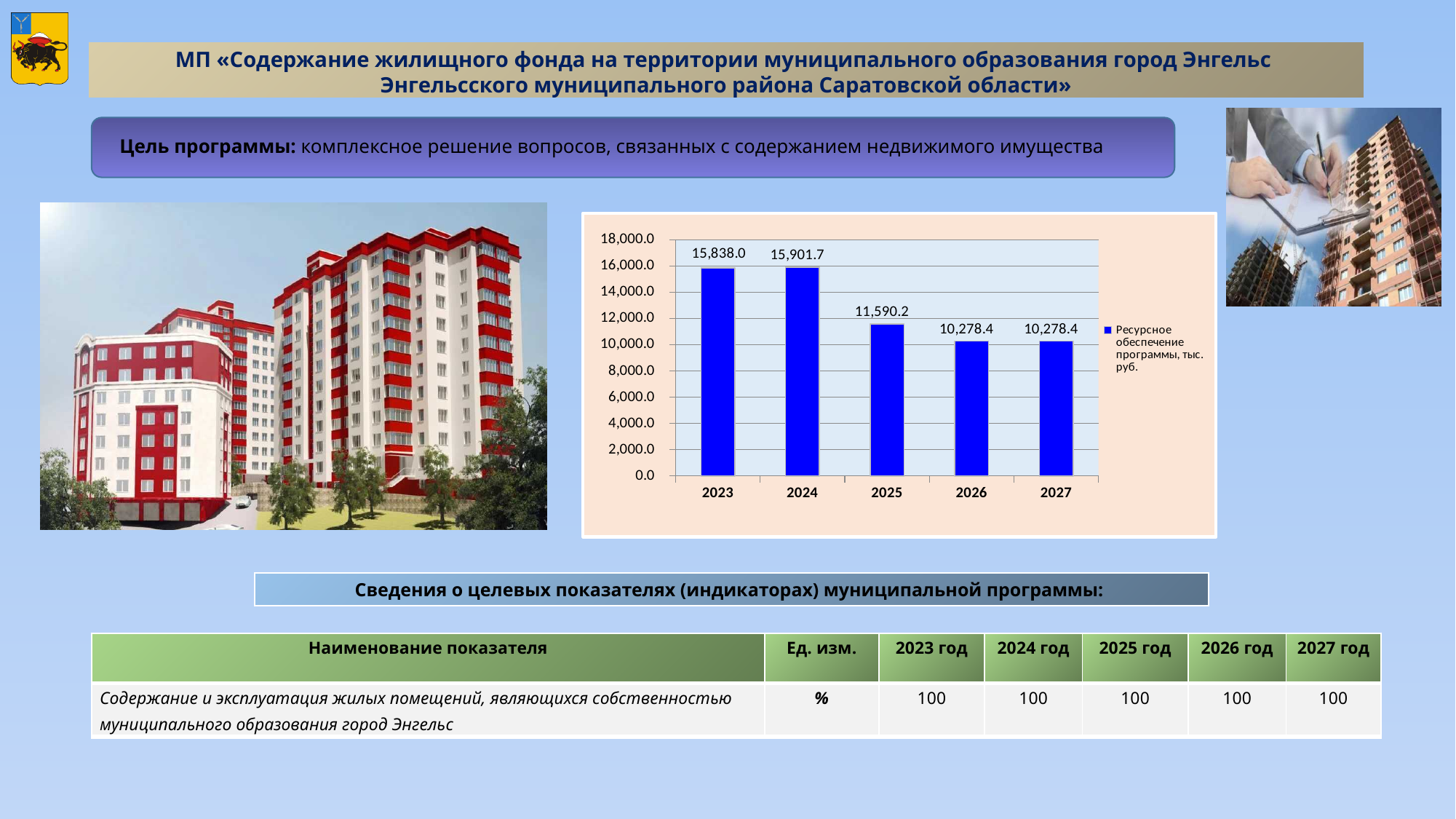
What is the difference between the values for 2025 and 2026? 1,311.8 What is the value for 2023 in the bar chart? 15,838.0 What is the difference between the values for 2024 and 2023? 63.7 Which year has the highest value in the bar chart? 2024 How many series does the legend of the bar chart list? 1 What is the value for 2025 in the bar chart? 11,590.2 Is the value for 2026 greater or less than 12,000.0? less How many years are shown on the x axis of the bar chart? 5 Which is larger, the value for 2023 or the value for 2025? 2023 What is the legend entry of the bar chart? Ресурсное обеспечение программы, тыс. руб. What kind of chart is shown on the slide? bar chart What is the value for 2027 in the bar chart? 10,278.4